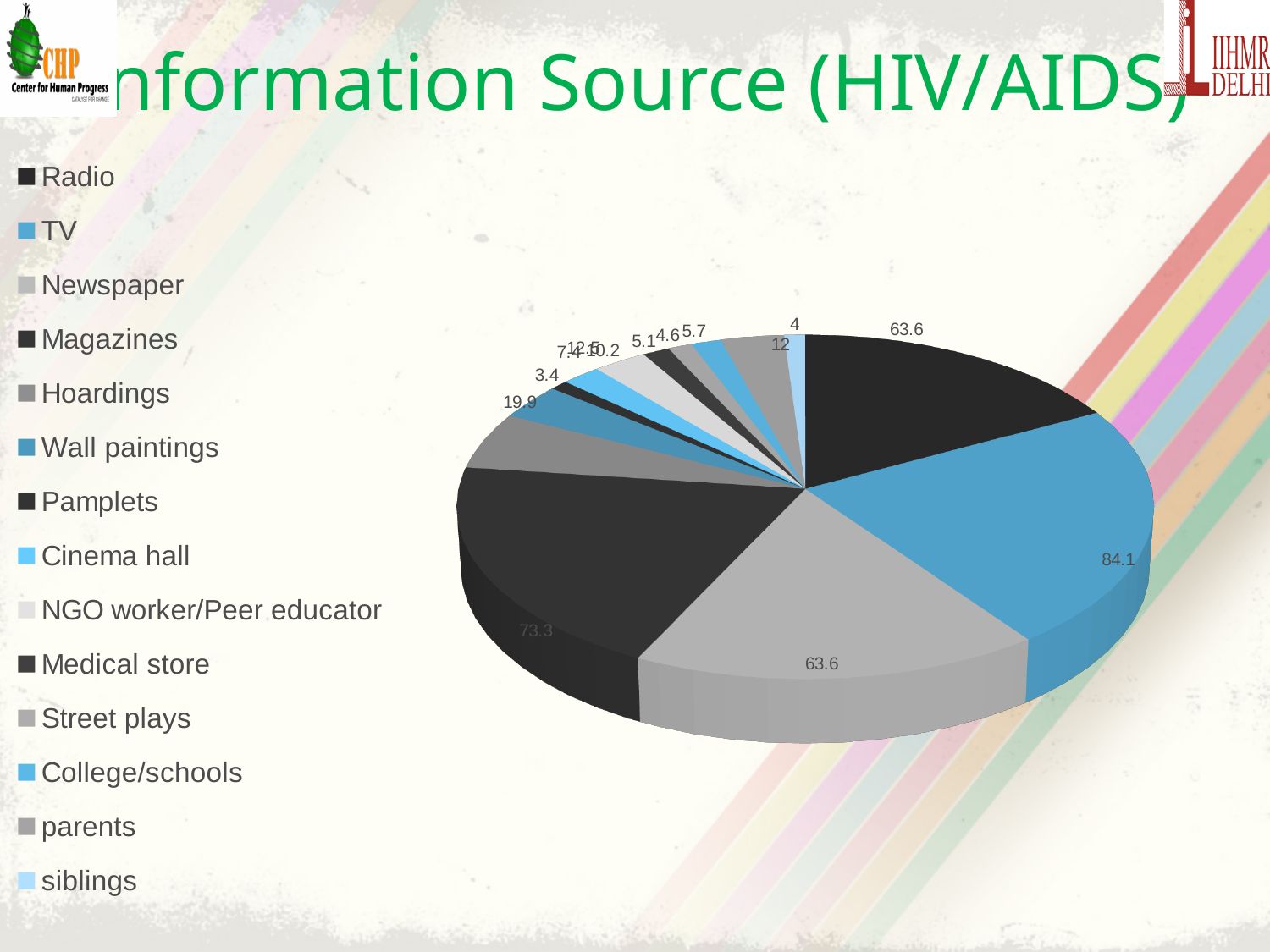
What type of chart is shown on the slide? Pie chart What is the difference between the values for TV and Radio? 20.5 What is the title of the chart on the slide? Information Source (HIV/AIDS) How many categories does the legend of the pie chart list? 14 Which information source has the highest value in the pie chart? TV What is the value shown for siblings in the pie chart? 4 What is the value shown for TV in the pie chart? 84.1 What is the value shown for Magazines in the pie chart? 73.3 Which has a larger value, Magazines or Newspaper? Magazines What is the value shown for Hoardings in the pie chart? 19.9 What is the value shown for Radio in the pie chart? 63.6 Which information source has the lowest value in the pie chart? Pamplets